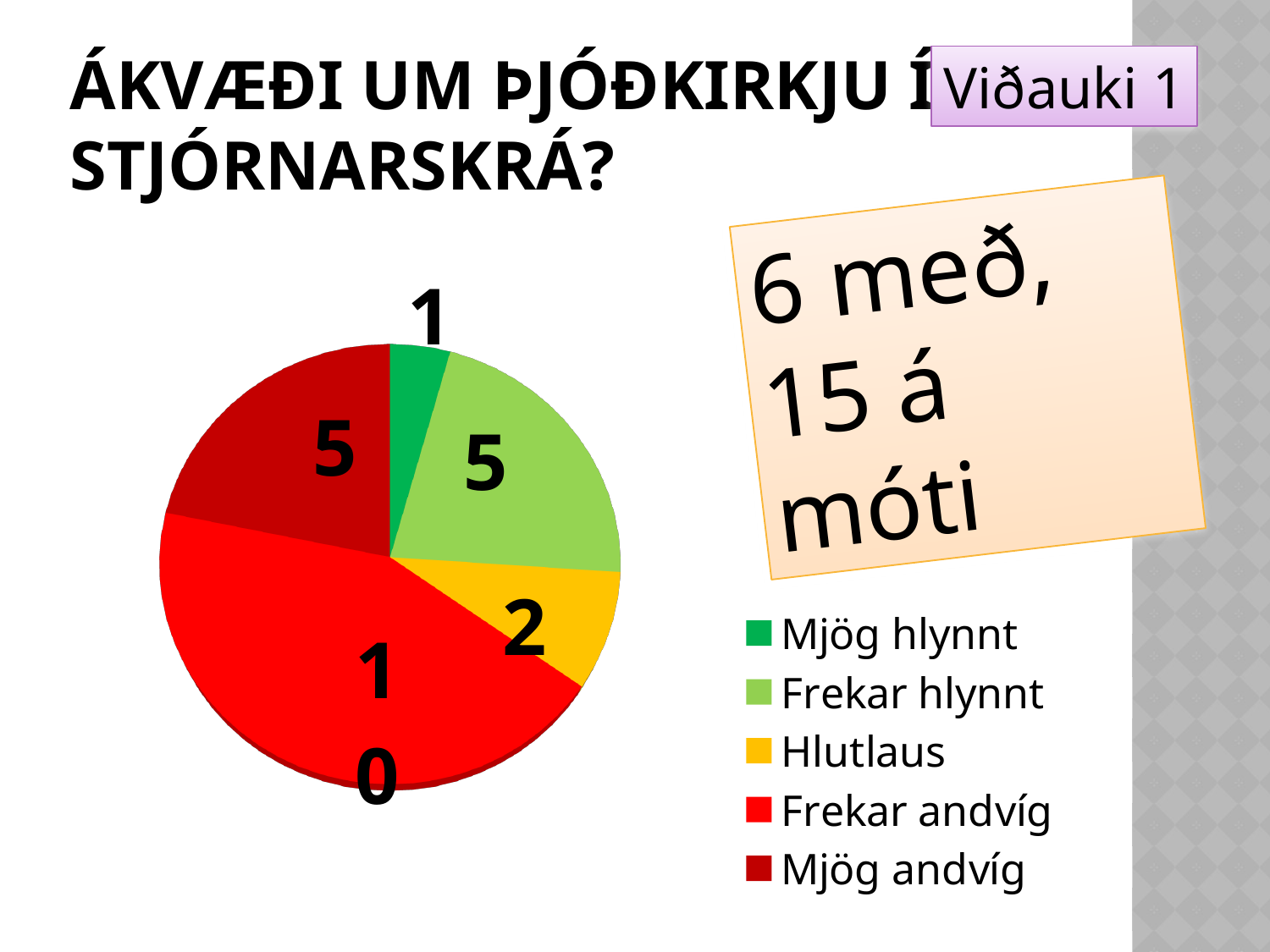
How many entries does the legend list? 5 Which is larger, the value for Hlutlaus or the value for Frekar hlynnt? Frekar hlynnt What kind of chart is shown on the slide? pie chart What is the value for Mjög hlynnt? 1 Which category has the smallest slice? Mjög hlynnt What is the value for Frekar andvíg? 10 Which category has the largest slice? Frekar andvíg What colour is the Hlutlaus slice? yellow What is the difference between the values for Frekar andvíg and Mjög andvíg? 5 How many slices does the pie chart have? 5 What is the value for Frekar hlynnt? 5 What is the value for Hlutlaus? 2